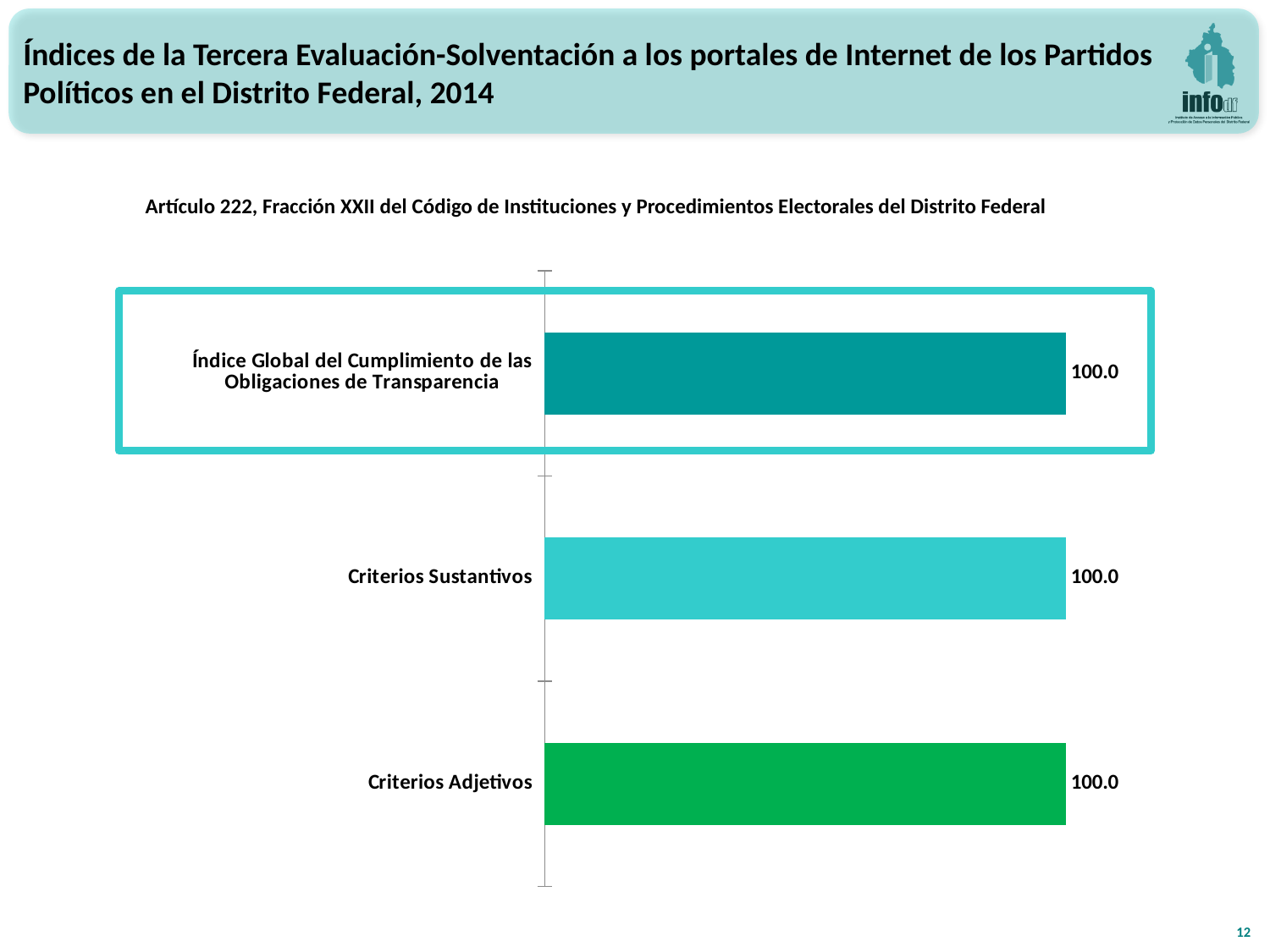
What is the difference between the values for Criterios Sustantivos and Criterios Adjetivos? 0.0 What is the value for Índice Global del Cumplimiento de las Obligaciones de Transparencia? 100.0 Which category is highlighted with a box around it in the chart? Índice Global del Cumplimiento de las Obligaciones de Transparencia What is the title shown above the chart? Artículo 222, Fracción XXII del Código de Instituciones y Procedimientos Electorales del Distrito Federal What kind of chart is shown on the slide? Bar chart What is the value for Criterios Adjetivos? 100.0 What is the value for Criterios Sustantivos? 100.0 How many categories are shown in the chart? 3 Do all three categories in the chart have the same value? Yes